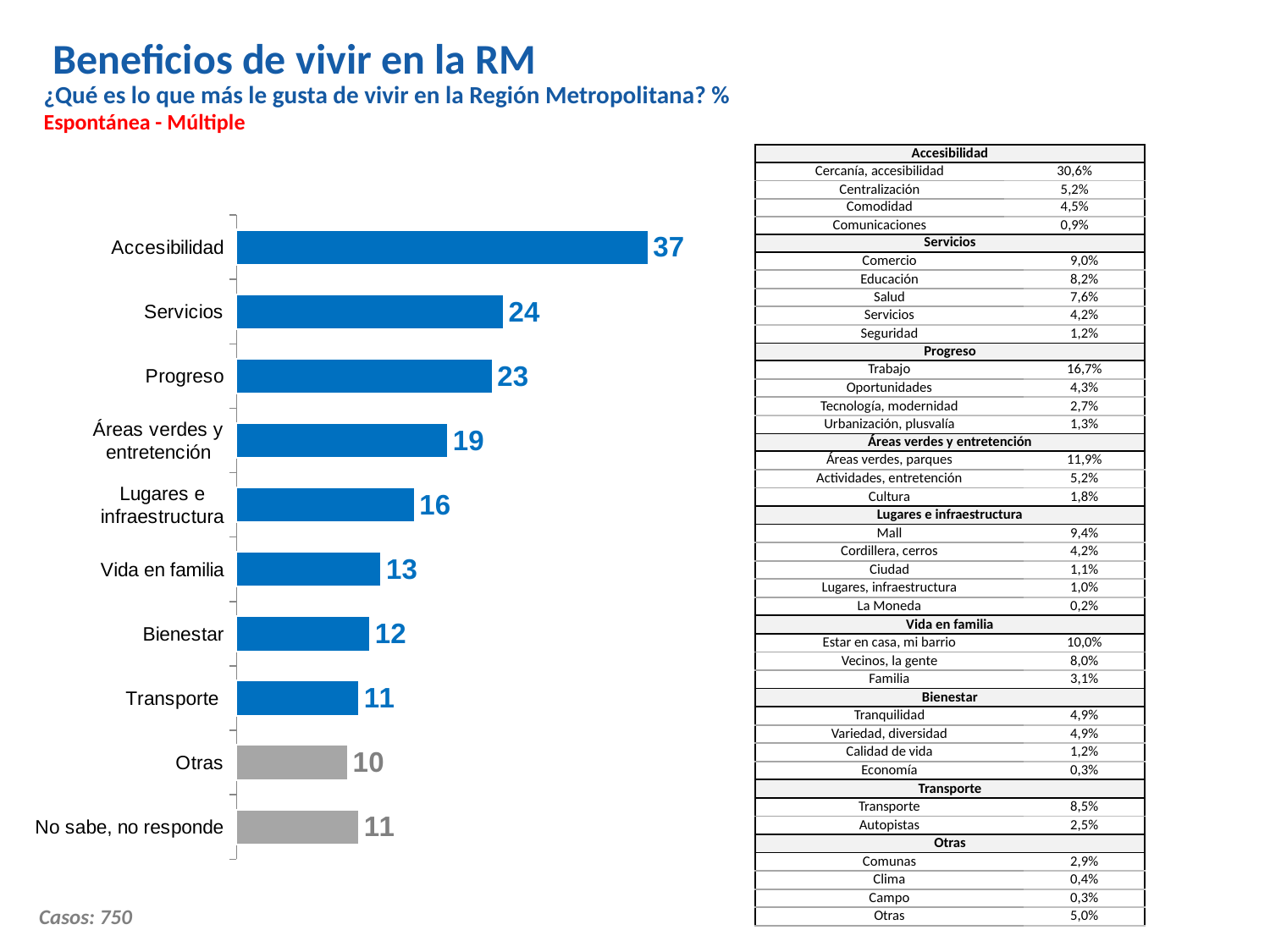
What is the value for Áreas verdes y entretención? 19 What is the value for No sabe, no responde? 11 Which category has the highest value? Accesibilidad What is the difference between the values for Accesibilidad and Servicios? 13 Which category has the lowest value? Otras Which two categories are drawn in grey rather than blue? Otras and No sabe, no responde Which is larger, the value for Servicios or the value for Progreso? Servicios What is the value for Vida en familia? 13 What is the difference between the values for Progreso and Bienestar? 11 How many categories are shown in the bar chart? 10 What kind of chart is shown on the slide? Bar chart What is the value for Accesibilidad? 37